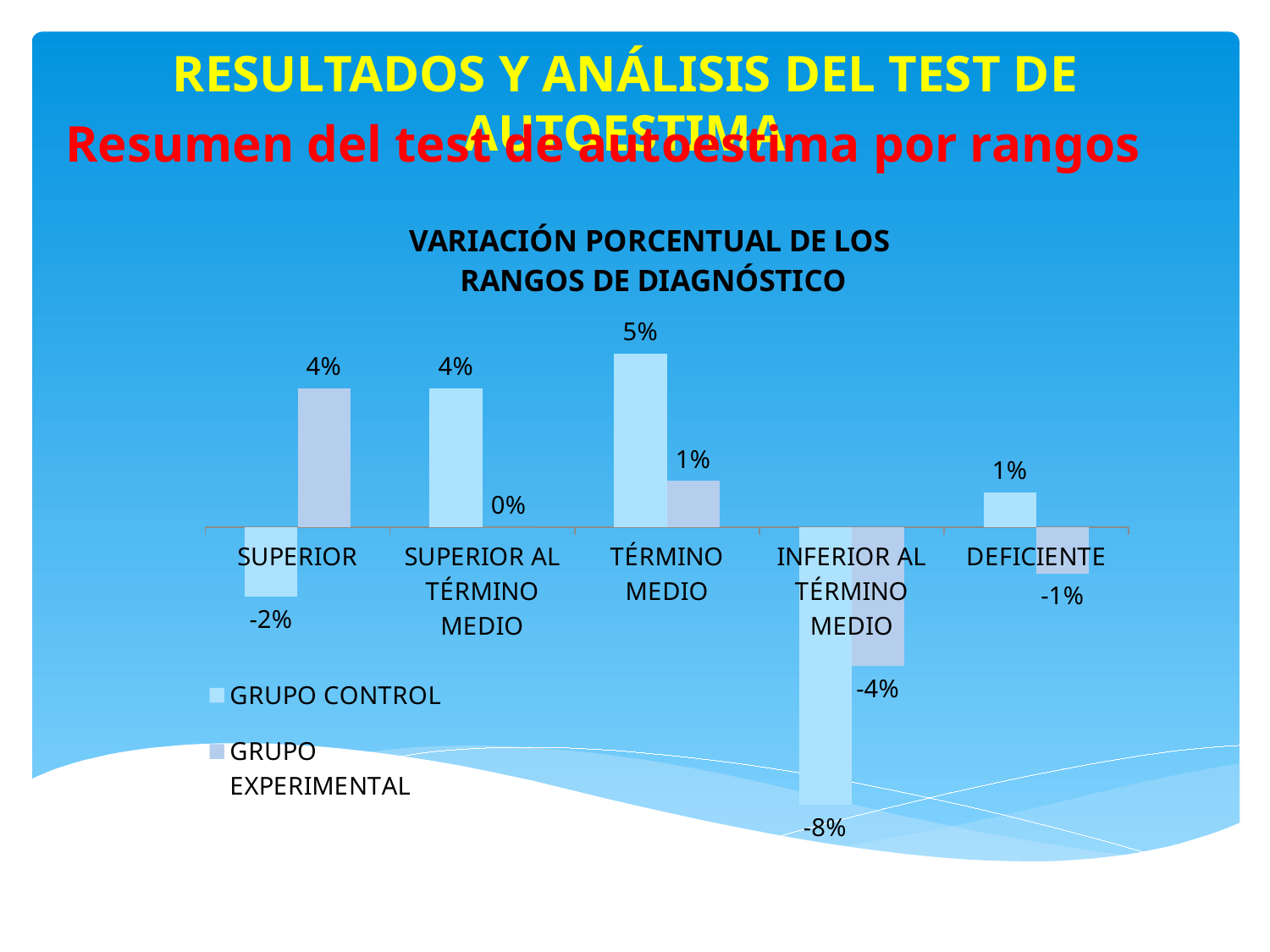
What is the GRUPO EXPERIMENTAL value for DEFICIENTE? -1% What is the title of the chart? VARIACIÓN PORCENTUAL DE LOS RANGOS DE DIAGNÓSTICO How many categories are shown on the x axis? 5 For SUPERIOR AL TÉRMINO MEDIO, which series has the larger value, GRUPO CONTROL or GRUPO EXPERIMENTAL? GRUPO CONTROL How many series does the legend list? 2 Which category has the lowest GRUPO EXPERIMENTAL value? INFERIOR AL TÉRMINO MEDIO What is the GRUPO CONTROL value for INFERIOR AL TÉRMINO MEDIO? -8% What is the GRUPO CONTROL value for TÉRMINO MEDIO? 5% What is the GRUPO EXPERIMENTAL value for SUPERIOR? 4% What is the difference between the GRUPO CONTROL and GRUPO EXPERIMENTAL values for INFERIOR AL TÉRMINO MEDIO? 4% Which category has the highest GRUPO CONTROL value? TÉRMINO MEDIO What kind of chart is shown on the slide? Bar chart